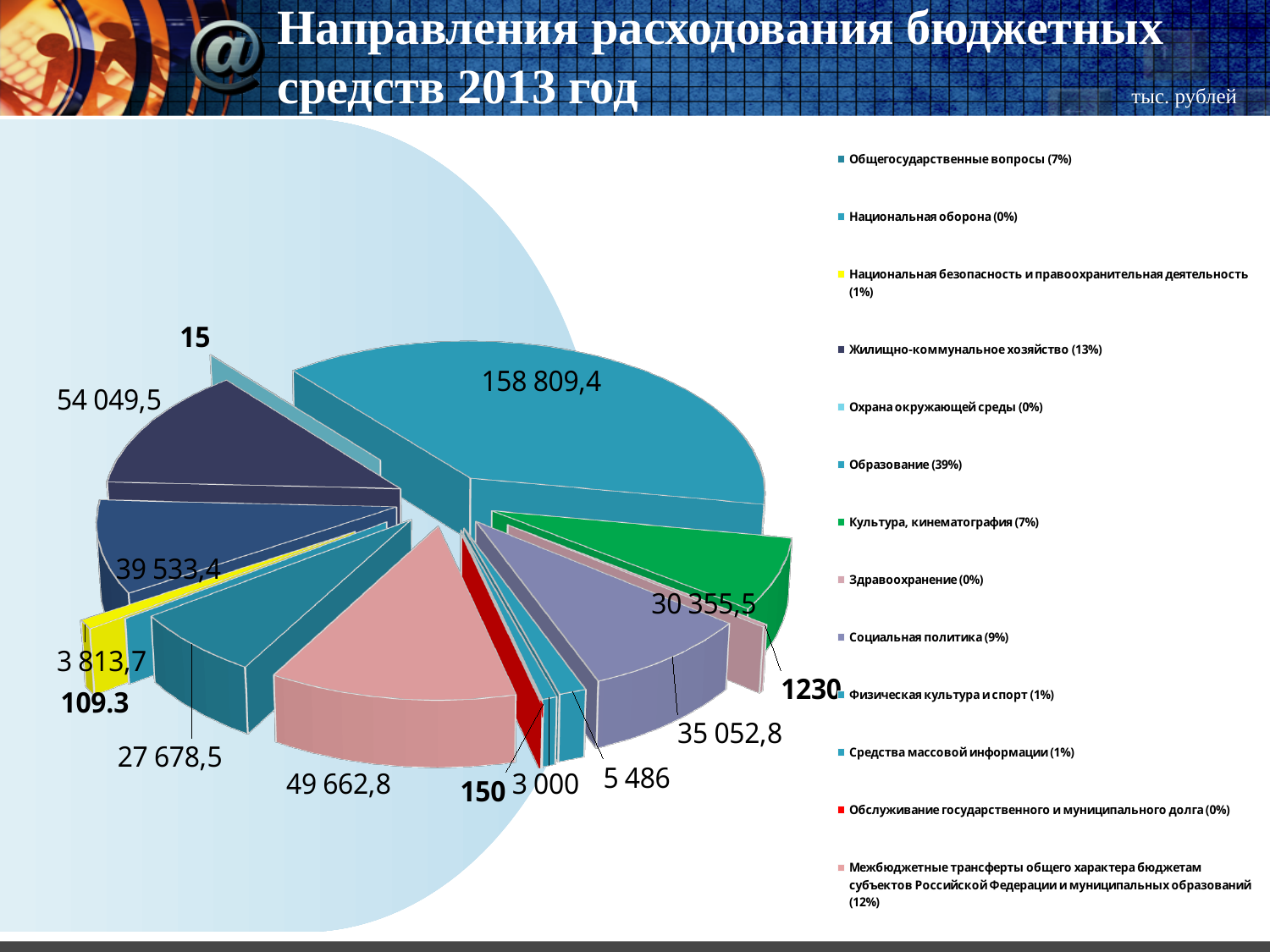
In what units are the values on the chart given, according to the slide? тыс. рублей What is the largest value labelled on the pie chart? 158 809,4 What is the value labelled on the red slice of the pie chart? 150 How many entries does the legend list? 13 What percentage does the legend give for Жилищно-коммунальное хозяйство? 13% What is the difference between the slice labelled 158 809,4 and the slice labelled 54 049,5? 104 759,9 What percentage does the legend give for Образование? 39% What type of chart is shown on the slide? pie chart What is the smallest value labelled on the pie chart? 15 What is the value labelled on the green slice of the pie chart? 30 355,5 Which is larger: the slice labelled 49 662,8 or the slice labelled 35 052,8? 49 662,8 What percentage does the legend give for Культура, кинематография? 7%